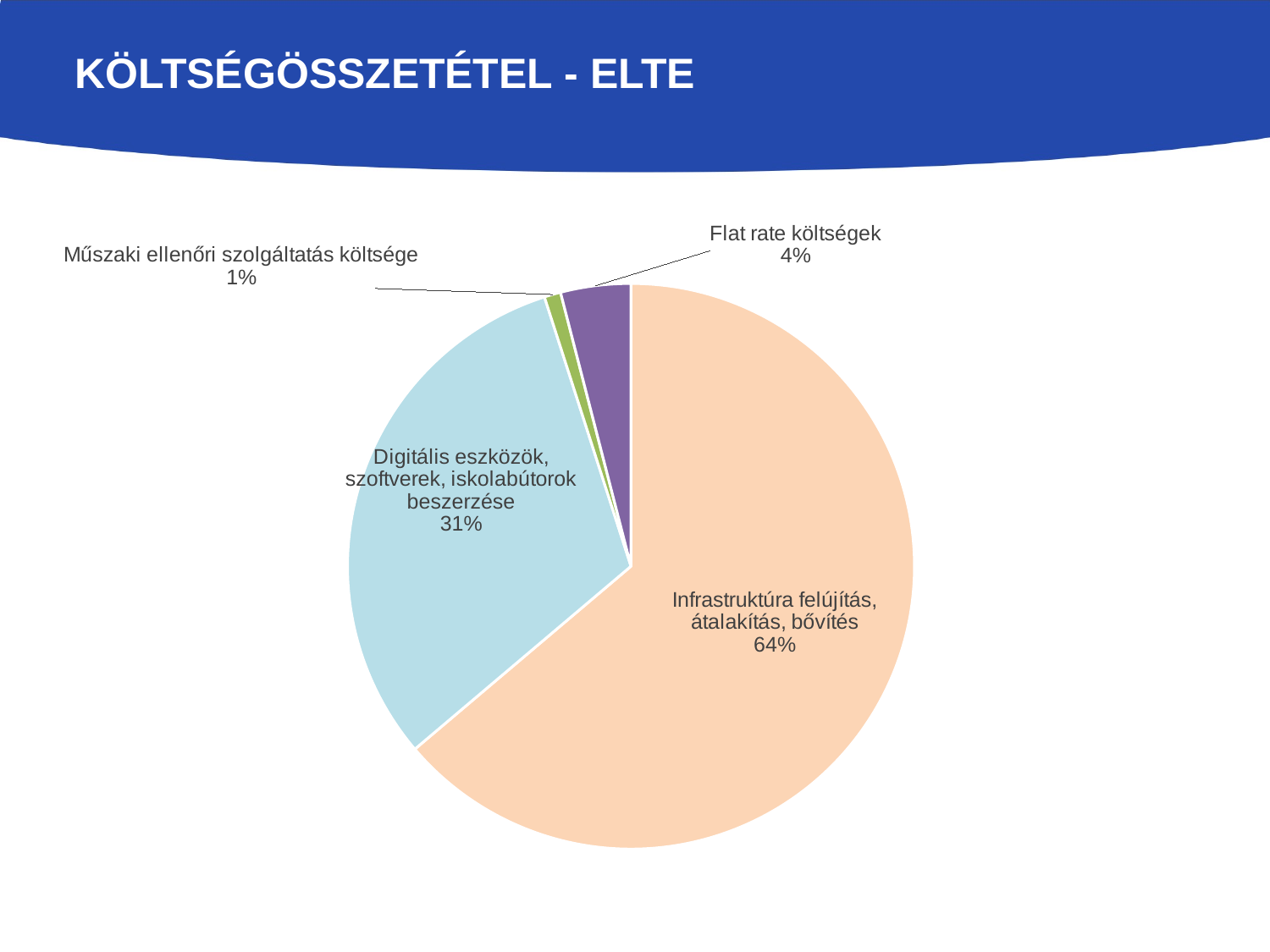
Which is larger: "Flat rate költségek" or "Műszaki ellenőri szolgáltatás költsége"? Flat rate költségek Which category has the largest slice of the pie? Infrastruktúra felújítás, átalakítás, bővítés What is the title of the slide containing the chart? KÖLTSÉGÖSSZETÉTEL - ELTE What is the difference in percentage points between "Infrastruktúra felújítás, átalakítás, bővítés" and "Digitális eszközök, szoftverek, iskolabútorok beszerzése"? 33 percentage points How many slices does the pie chart have? 4 Which category has the smallest slice of the pie? Műszaki ellenőri szolgáltatás költsége What is the value shown for "Flat rate költségek"? 4% What kind of chart is shown on the slide? pie chart What colour is the slice for "Digitális eszközök, szoftverek, iskolabútorok beszerzése"? light blue What is the value shown for "Műszaki ellenőri szolgáltatás költsége"? 1% What share of the pie does "Digitális eszközök, szoftverek, iskolabútorok beszerzése" represent? 31% What share of the pie does "Infrastruktúra felújítás, átalakítás, bővítés" represent? 64%